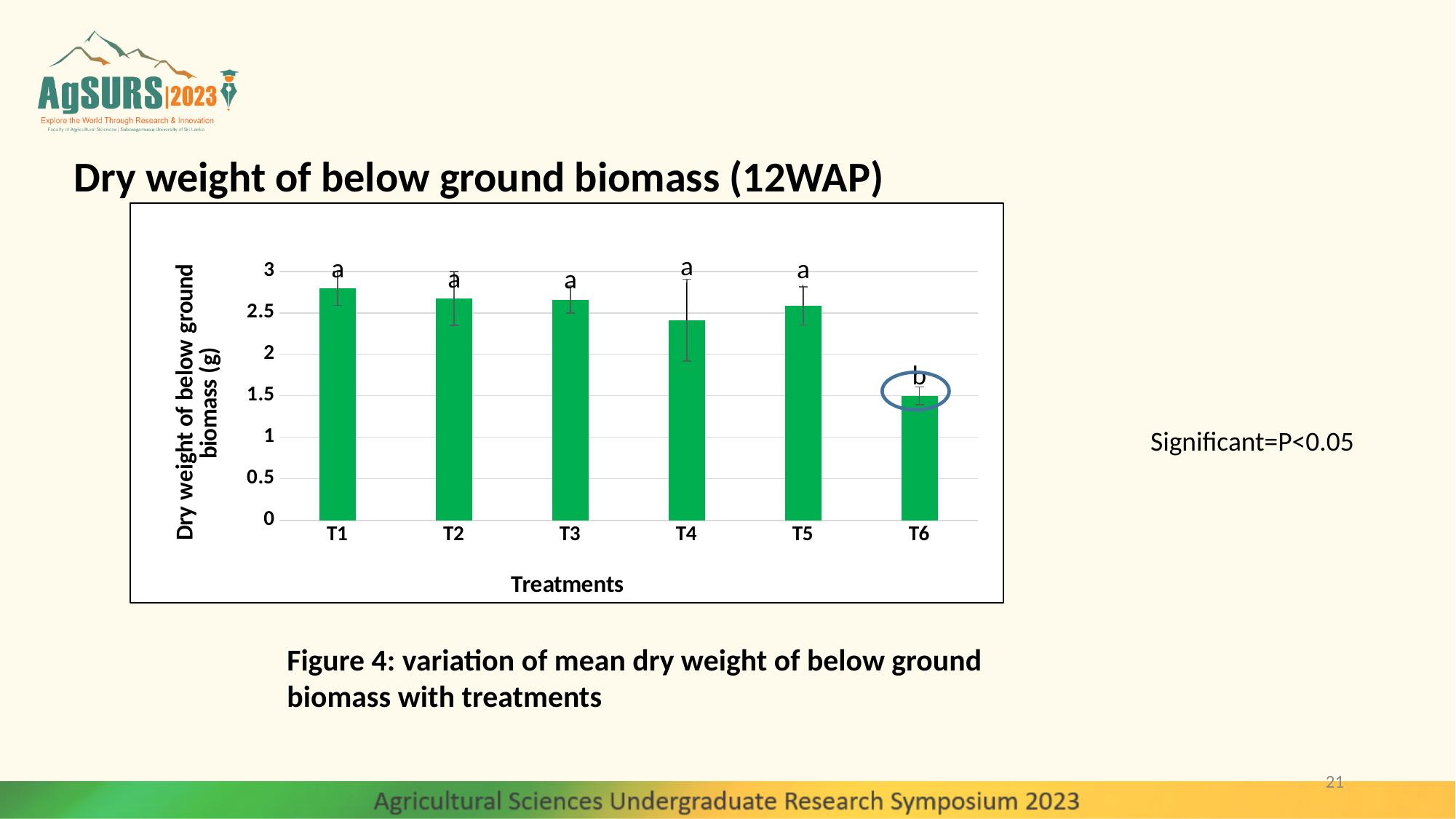
Which has a larger dry weight of below ground biomass, T1 or T6? T1 Which letter is printed above the T6 bar? b Is the value for T6 greater or less than 2? less Which has a larger dry weight of below ground biomass, T4 or T5? T5 What is the title of the x axis? Treatments How many treatments are plotted on the x axis? 6 Which treatment has the highest dry weight of below ground biomass? T1 Is the value for T6 greater or less than 1? greater Is the value for T1 greater or less than 2.5? greater Which treatment has the lowest dry weight of below ground biomass? T6 What kind of chart is shown on the slide? Bar chart